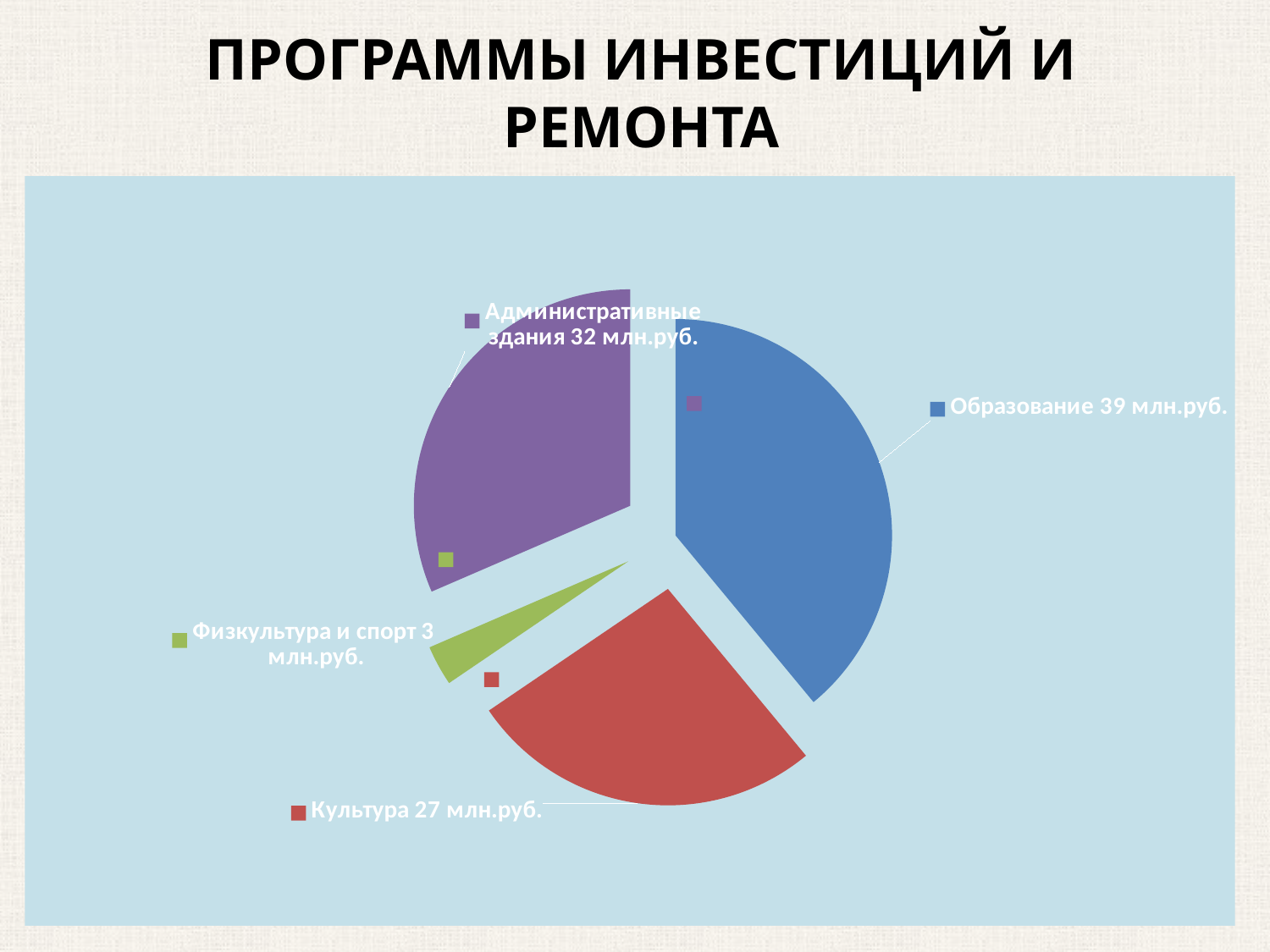
What is the title of the slide? ПРОГРАММЫ ИНВЕСТИЦИЙ И РЕМОНТА What is the total of all four values shown in the pie chart? 101 млн.руб. What kind of chart is shown on the slide? pie chart Which is larger, the value for Административные здания or the value for Культура? Административные здания How many slices does the pie chart have? 4 Which category has the smallest slice of the pie? Физкультура и спорт What is the value for Административные здания? 32 млн.руб. What is the value for Культура? 27 млн.руб. What is the difference between the values for Образование and Культура? 12 млн.руб. Which category has the largest slice of the pie? Образование What is the value for Образование? 39 млн.руб. What is the value for Физкультура и спорт? 3 млн.руб.